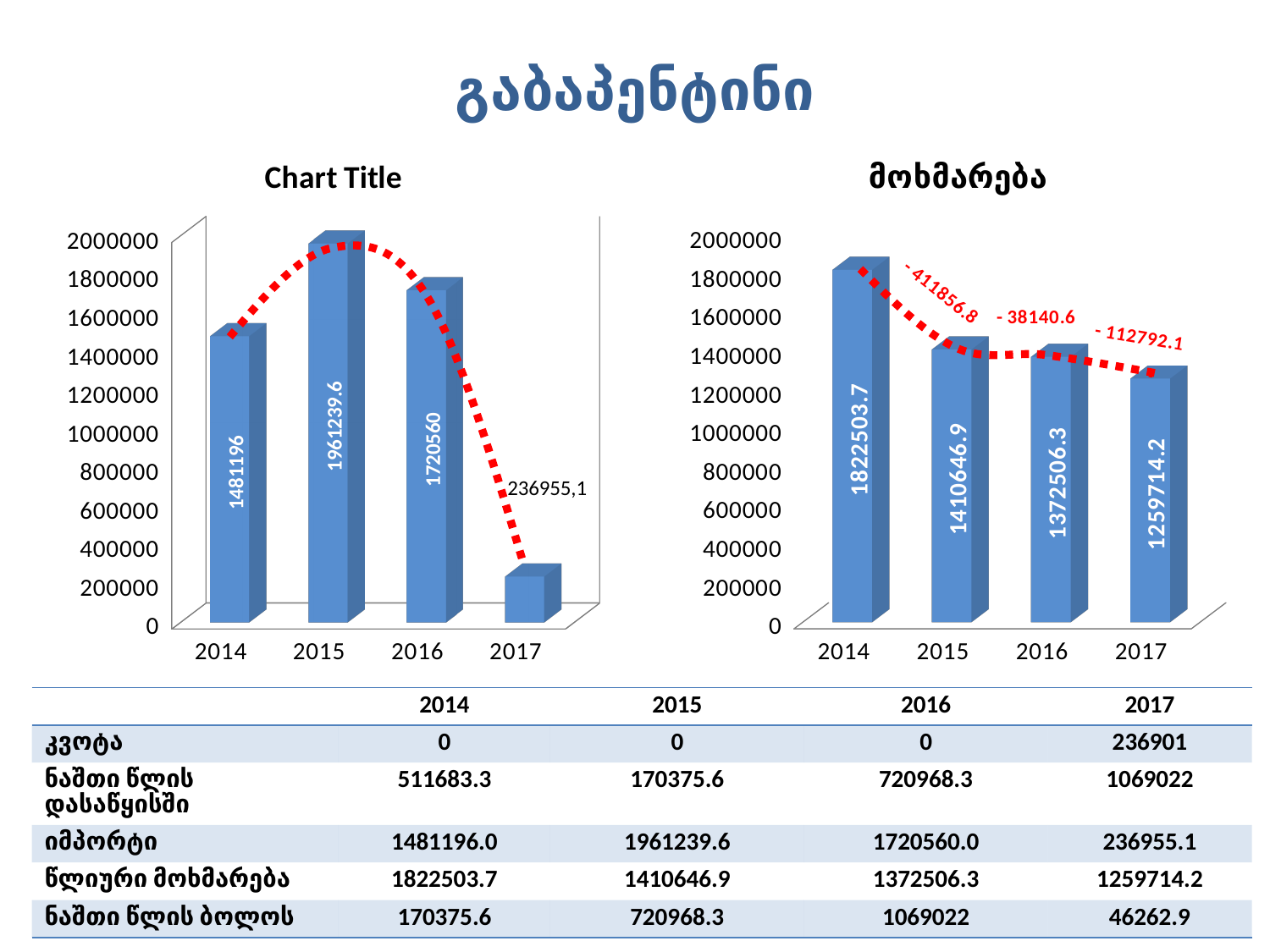
In the chart titled "Chart Title" on the left, which year has the lowest value? 2017 In the chart titled "მოხმარება" on the right, what is the value for 2017? 1259714.2 In the chart titled "Chart Title" on the left, what is the value for 2017? 236955,1 In the chart titled "Chart Title" on the left, which year has the highest value? 2015 In the chart titled "მოხმარება" on the right, which year has the highest value? 2014 What type of chart is the chart titled "მოხმარება" on the right? bar chart In the chart titled "მოხმარება" on the right, what is the value for 2014? 1822503.7 In the chart titled "Chart Title" on the left, is the value for 2016 greater or less than 1600000? greater In the chart titled "მოხმარება" on the right, how many years are shown on the x axis? 4 In the chart titled "მოხმარება" on the right, what is the difference between the 2014 and 2015 values? 411856.8 In the chart titled "მოხმარება" on the right, do the values rise or fall from 2014 to 2017? fall In the chart titled "Chart Title" on the left, what is the value for 2015? 1961239.6